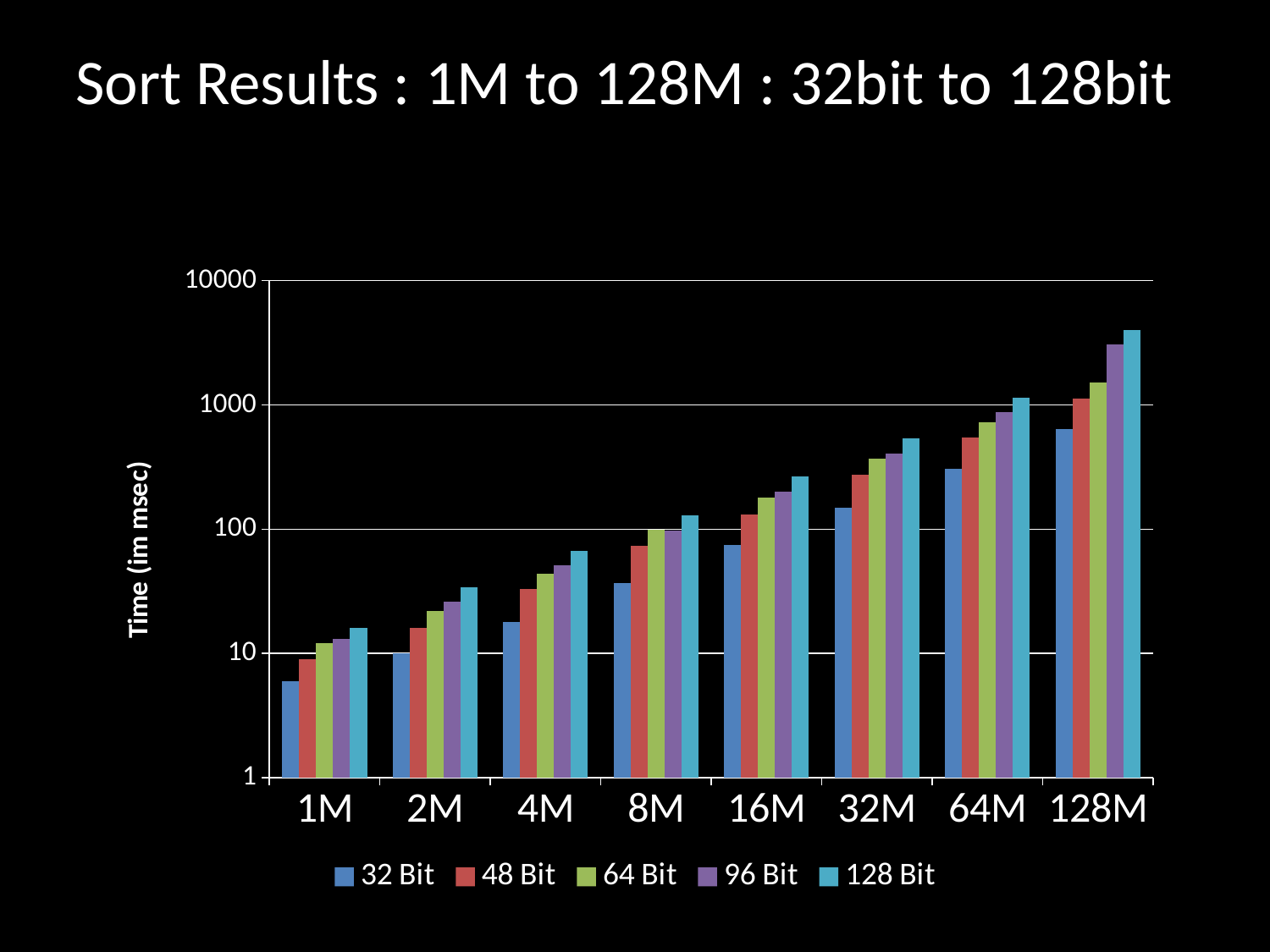
What kind of chart is shown on the slide? bar chart At 128M, which is larger: the value for 32 Bit or the value for 96 Bit? 96 Bit Is the value for 128 Bit at 4M greater or less than 100? less Is the value for 128 Bit at 8M greater or less than 100? greater How many series does the legend list? 5 What is the title of the chart? Sort Results : 1M to 128M : 32bit to 128bit Do the values for the 128 Bit series rise or fall as the x axis goes from 1M to 128M? rise Which category has the lowest value for the 32 Bit series? 1M Which category has the highest value for the 128 Bit series? 128M What is the label of the y axis? Time (im msec) How many categories are shown on the x axis? 8 Is the value for 32 Bit at 1M greater or less than 10? less